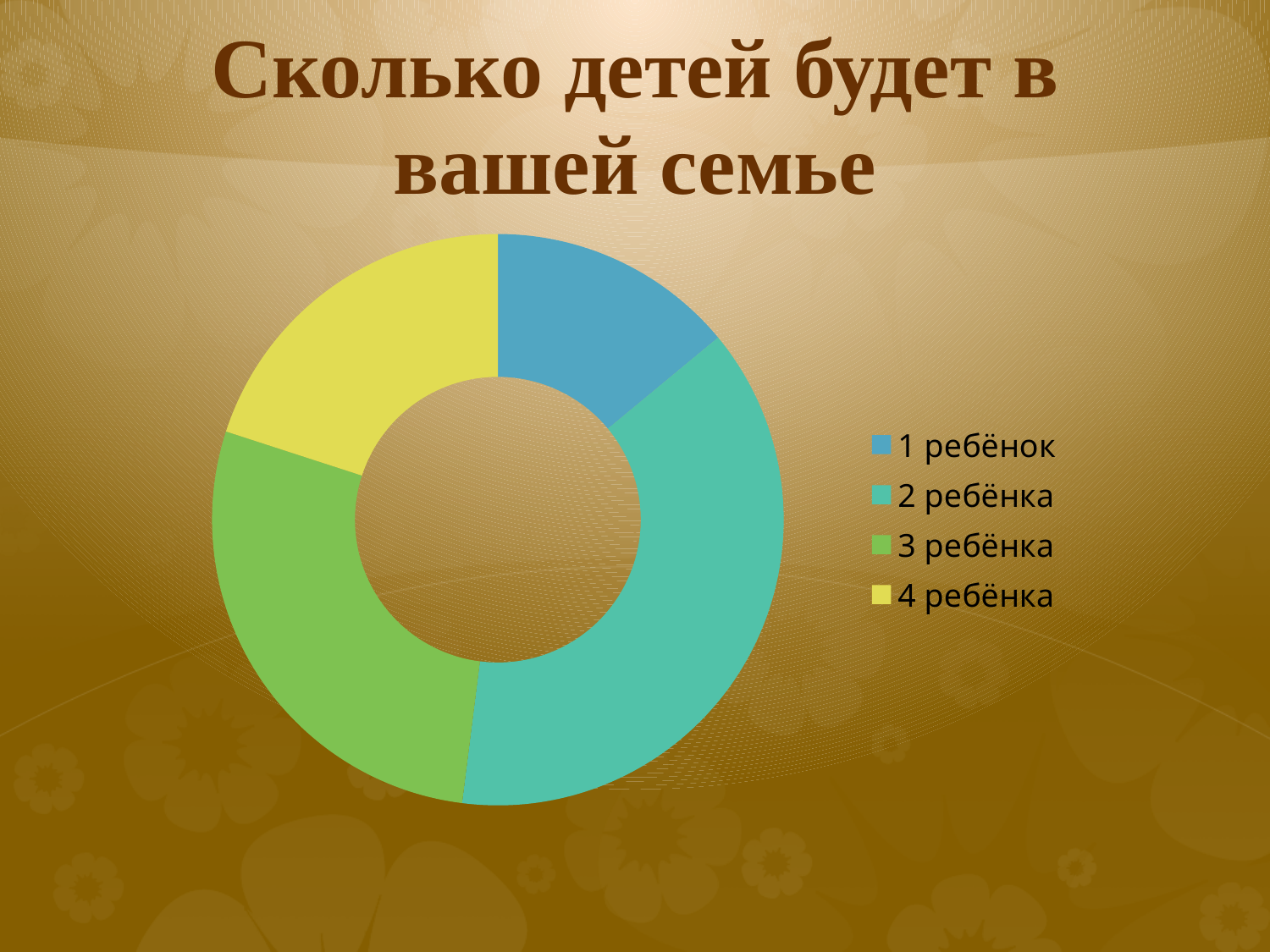
Which category has the largest share of the chart? 2 ребёнка How many categories does the chart show? 4 Which is larger: the share for 2 ребёнка or the share for 4 ребёнка? 2 ребёнка What kind of chart is shown on the slide? Doughnut chart Which is larger: the share for 1 ребёнок or the share for 3 ребёнка? 3 ребёнка Which is larger: the share for 1 ребёнок or the share for 4 ребёнка? 4 ребёнка What is the title of the slide? Сколько детей будет в вашей семье What colour represents the category 4 ребёнка in the chart? Yellow Which category has the smallest share of the chart? 1 ребёнок